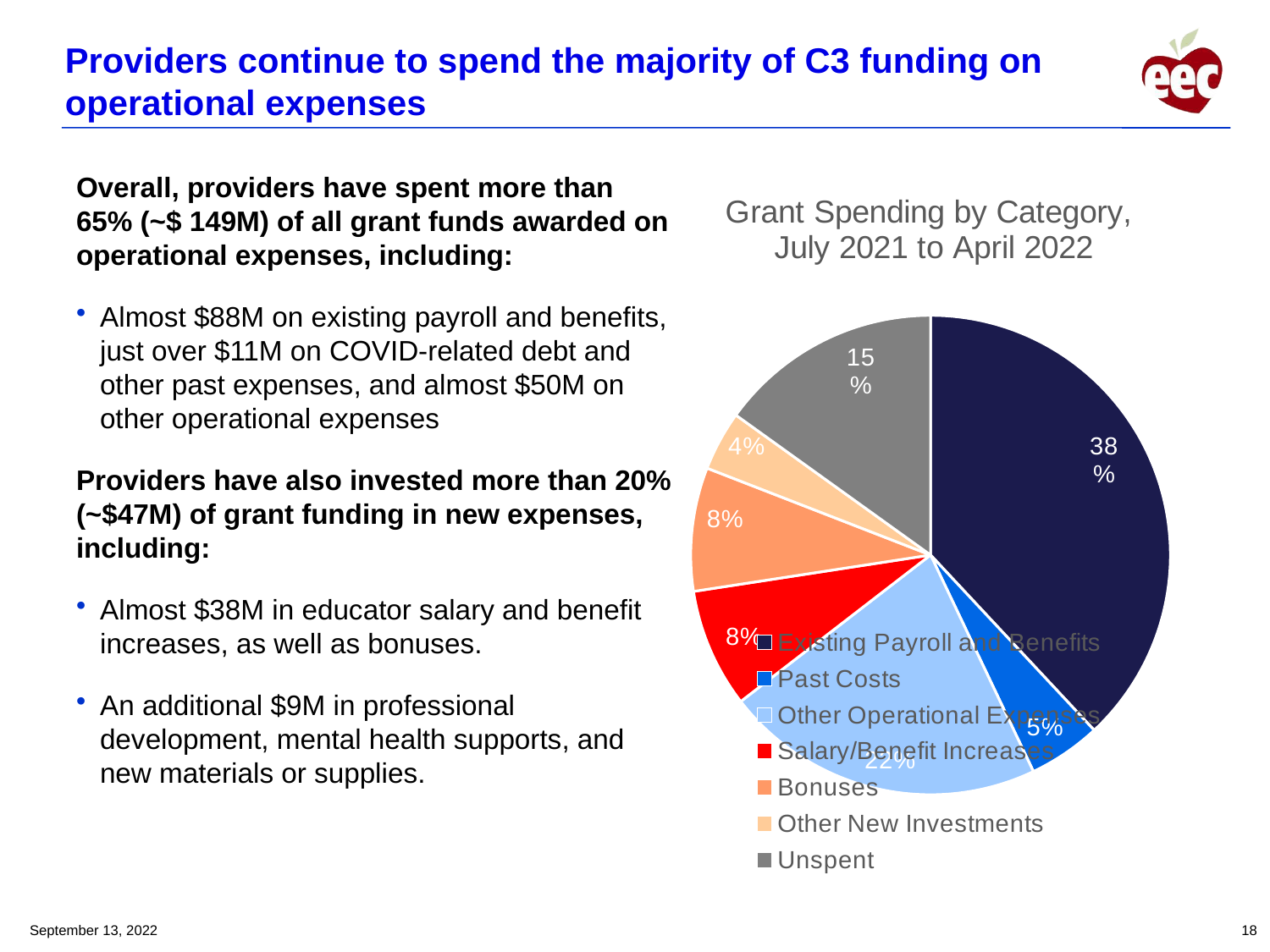
What percentage of the pie is Other Operational Expenses? 22% How many categories does the legend list? 7 Which category has the largest share of the pie? Existing Payroll and Benefits Which category has the smallest share of the pie? Other New Investments What percentage of the pie is Unspent? 15% What is the difference in percentage points between Existing Payroll and Benefits and Other Operational Expenses? 16 percentage points Which is larger, the share for Unspent or the share for Past Costs? Unspent What type of chart is shown on the slide? Pie chart What share of grant spending is Existing Payroll and Benefits? 38% What is the title of the chart? Grant Spending by Category, July 2021 to April 2022 What percentage of the pie is Other New Investments? 4% What percentage of the pie is Past Costs? 5%